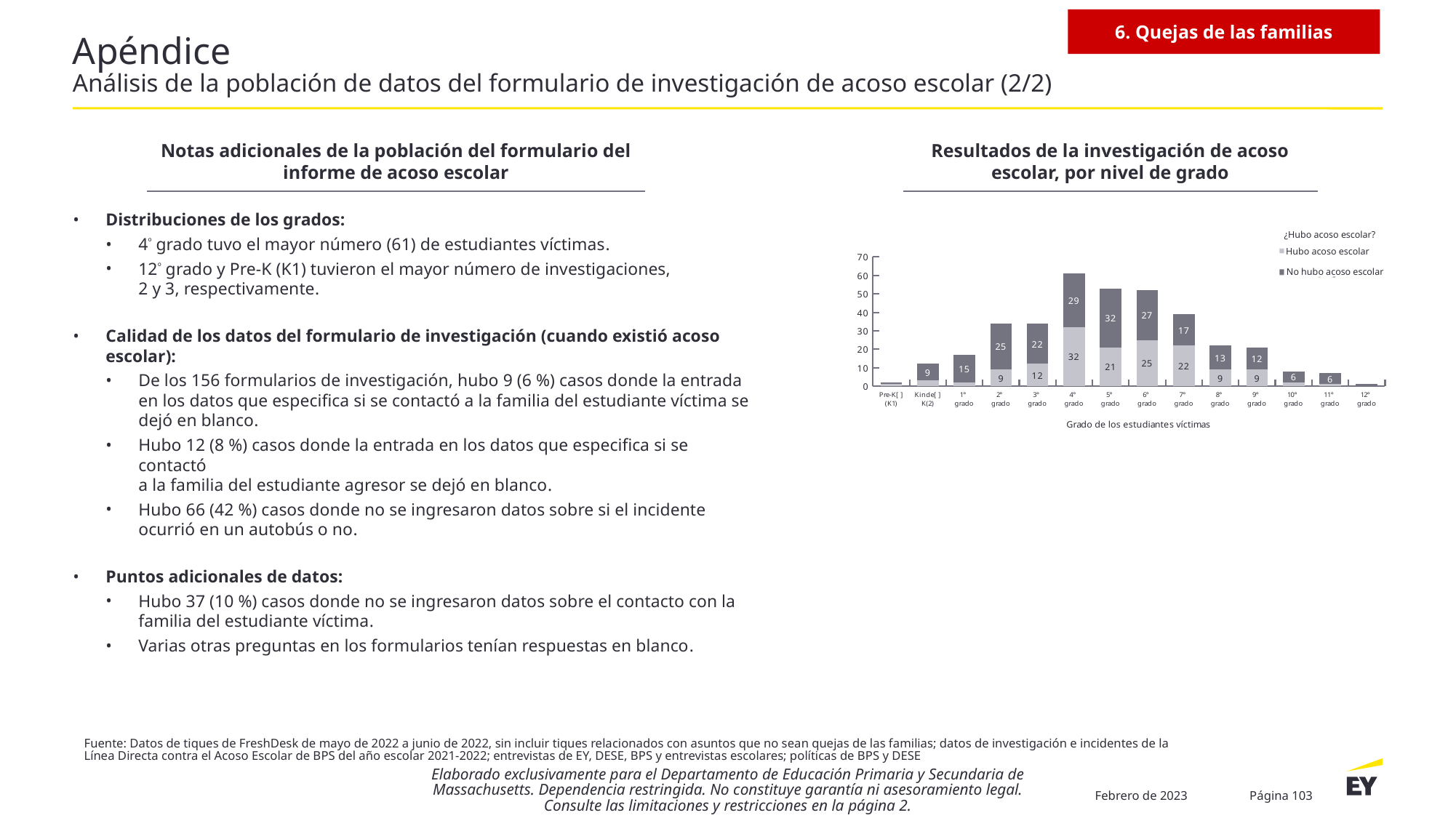
What is the value of 'Hubo acoso escolar' for 4º grado? 32 What kind of chart is shown on the slide? Stacked bar chart What is the value of 'No hubo acoso escolar' for 1º grado? 15 What is the difference between 'No hubo acoso escolar' for 6º grado and 'Hubo acoso escolar' for 6º grado? 2 What is the total of the stacked bar for 4º grado? 61 Which is larger: 'Hubo acoso escolar' for 7º grado or 'No hubo acoso escolar' for 7º grado? Hubo acoso escolar How many series does the chart legend list? 2 What is the total of the stacked bar for 7º grado? 39 What is the value of 'No hubo acoso escolar' for 5º grado? 32 Is the total value for Pre-K (K1) greater or less than 10? less How many grade-level categories are shown on the x axis of the chart? 14 Which grade has the highest total number of investigations? 4º grado